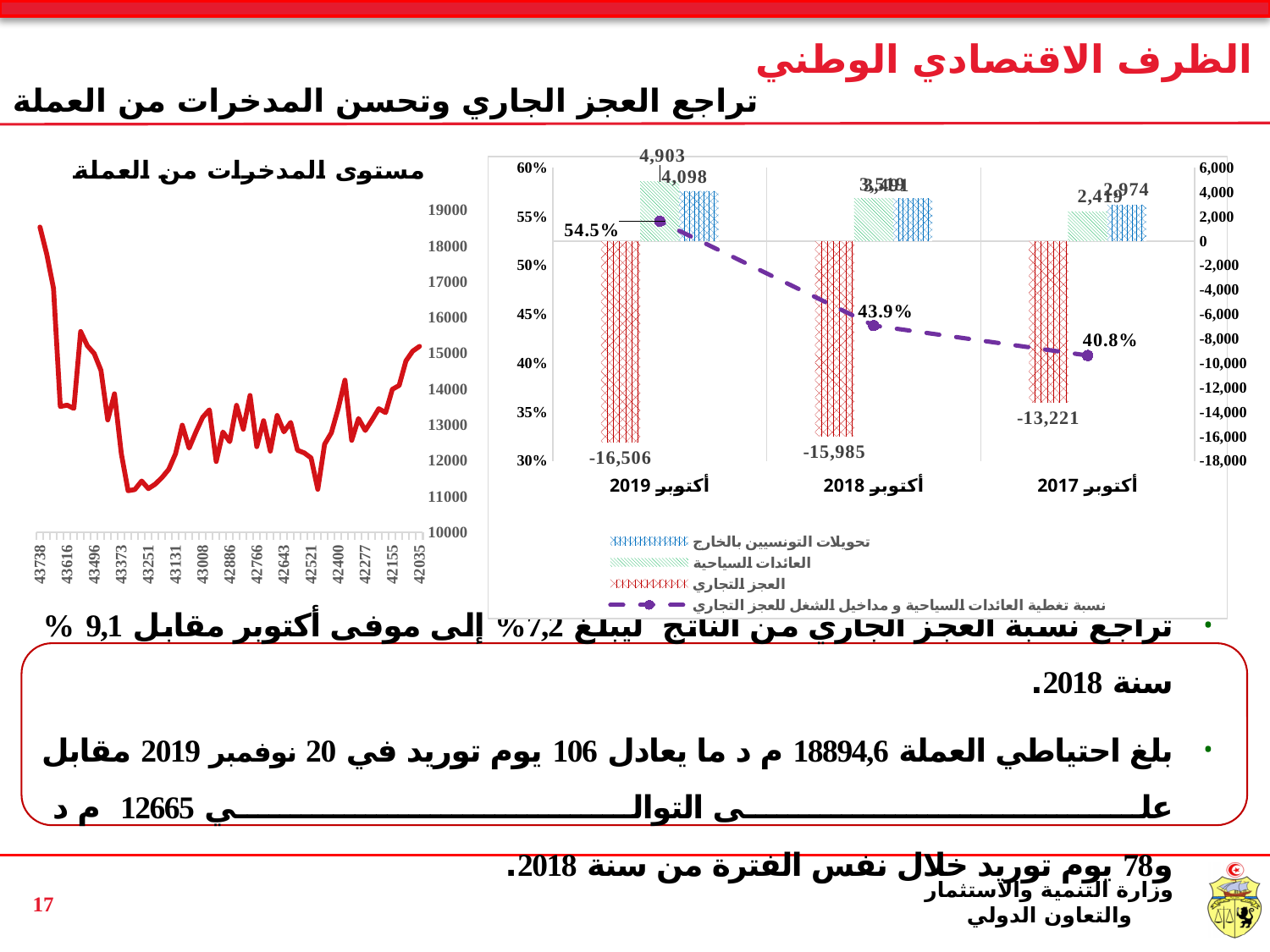
On the right chart, what is the coverage ratio value shown for أكتوبر 2017? 40.8% On the right chart, which period has the highest coverage ratio? أكتوبر 2019 What type of chart is the left chart titled 'مستوى المدخرات من العملة'? line chart On the right chart, what is the trade deficit (العجز التجاري) value shown for أكتوبر 2017? -13,221 On the right chart, what is the trade deficit (العجز التجاري) value shown for أكتوبر 2019? -16,506 How many periods (categories) are shown on the x axis of the right chart? 3 On the left chart, is the lowest point of the line greater or less than 12000? less On the right chart, what is the trade deficit (العجز التجاري) value shown for أكتوبر 2018? -15,985 How many series does the legend of the right chart list? 4 On the right chart, what is the tourism receipts (العائدات السياحية) value shown for أكتوبر 2019? 4,903 On the right chart, what is the coverage ratio (نسبة تغطية) value shown for أكتوبر 2019? 54.5% On the right chart, what is the difference in percentage points between the coverage ratio for أكتوبر 2019 (54.5%) and أكتوبر 2017 (40.8%)? 13.7 percentage points